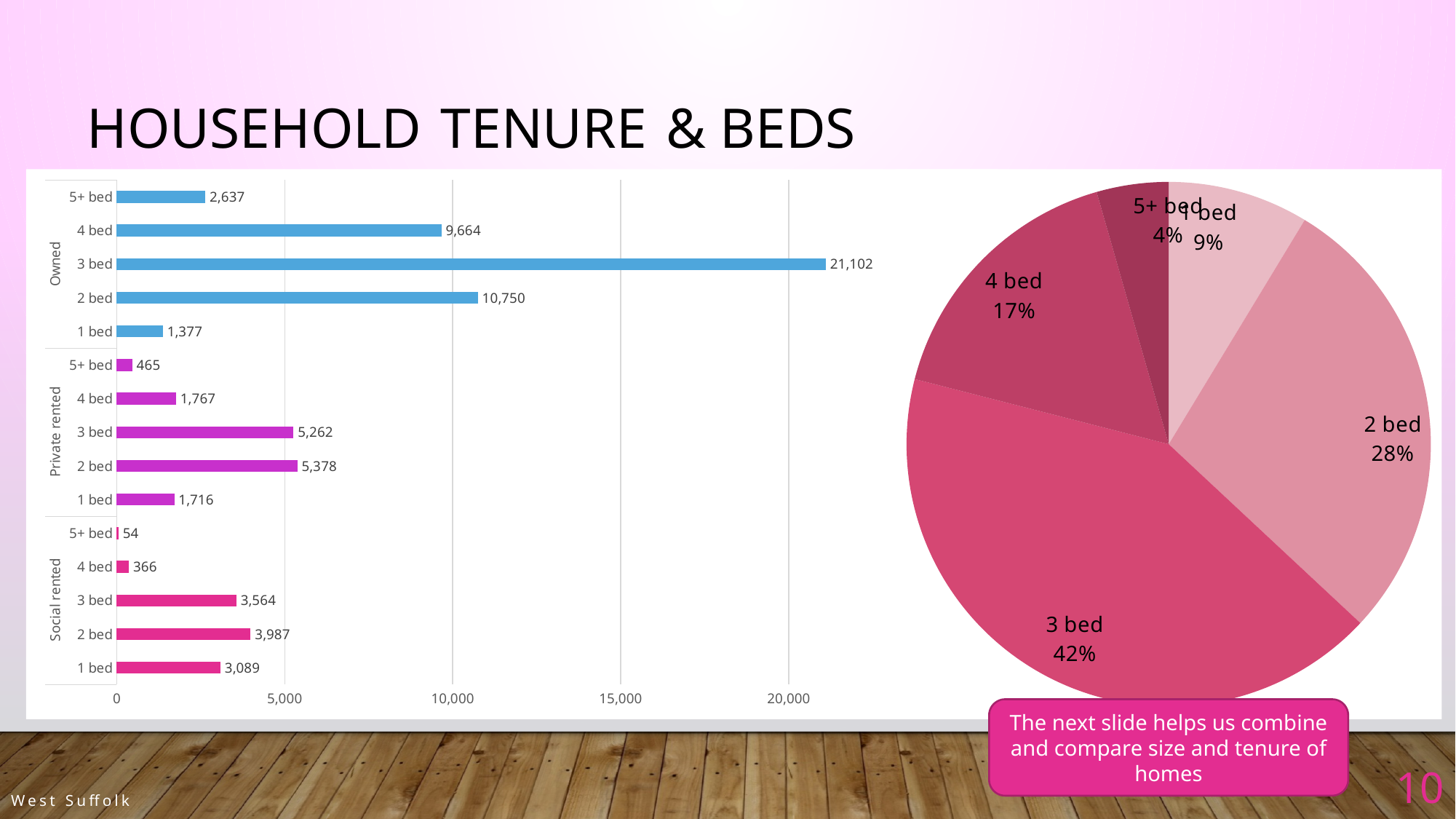
What kind of chart is the chart on the right of the slide? Pie chart In the bar chart on the left, which category in the Social rented group has the lowest value? 5+ bed What kind of chart is the chart on the left of the slide? Bar chart In the bar chart on the left, what is the value for 3 bed in the Owned group? 21,102 In the pie chart on the right, what share does 3 bed have? 42% In the pie chart on the right, which slice is the smallest? 5+ bed In the bar chart on the left, what is the difference between 2 bed and 4 bed in the Owned group? 1,086 In the bar chart on the left, what is the value for 5+ bed in the Social rented group? 54 In the bar chart on the left, which category has the highest value overall? 3 bed (Owned) In the bar chart on the left, how many bars are plotted in total? 15 In the bar chart on the left, which is larger: 3 bed in the Social rented group or 1 bed in the Social rented group? 3 bed in the Social rented group In the bar chart on the left, what is the value for 2 bed in the Private rented group? 5,378